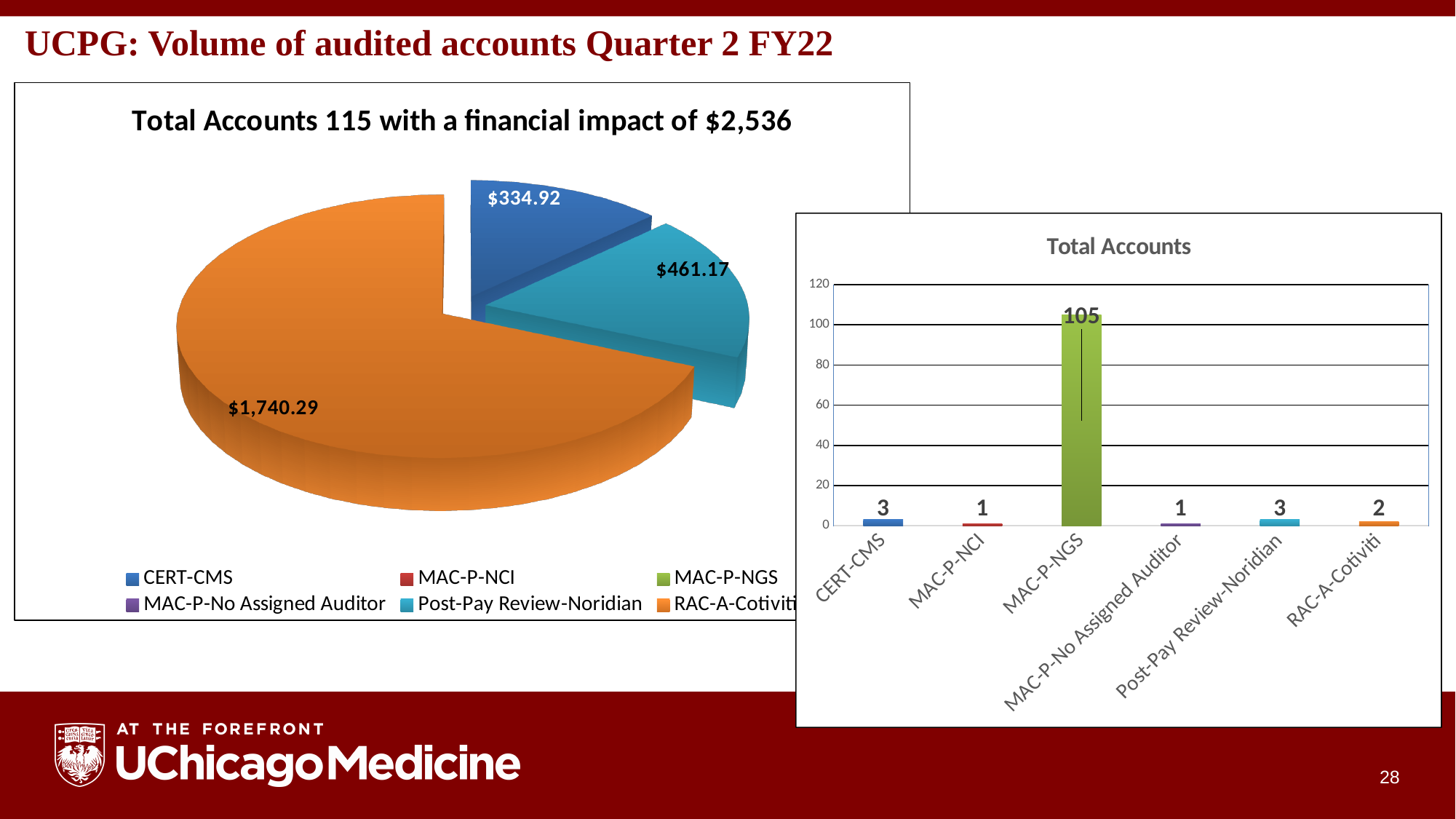
In the 'Total Accounts' bar chart, what is the value for RAC-A-Cotiviti? 2 How many entries does the legend of the pie chart list? 6 In the 'Total Accounts' bar chart, which is larger, the value for CERT-CMS or the value for RAC-A-Cotiviti? CERT-CMS In the 'Total Accounts' bar chart, what is the difference between the values for MAC-P-NGS and Post-Pay Review-Noridian? 102 In the pie chart, which labelled slice is the largest? $1,740.29 In the pie chart, what value is labelled on the blue slice? $334.92 How many categories are shown on the x axis of the 'Total Accounts' bar chart? 6 In the 'Total Accounts' bar chart, what is the value for MAC-P-NGS? 105 In the pie chart, what value is labelled on the orange slice? $1,740.29 What kind of chart is the chart on the left of the slide? Pie chart In the 'Total Accounts' bar chart, what is the value for CERT-CMS? 3 In the 'Total Accounts' bar chart, which category has the highest value? MAC-P-NGS